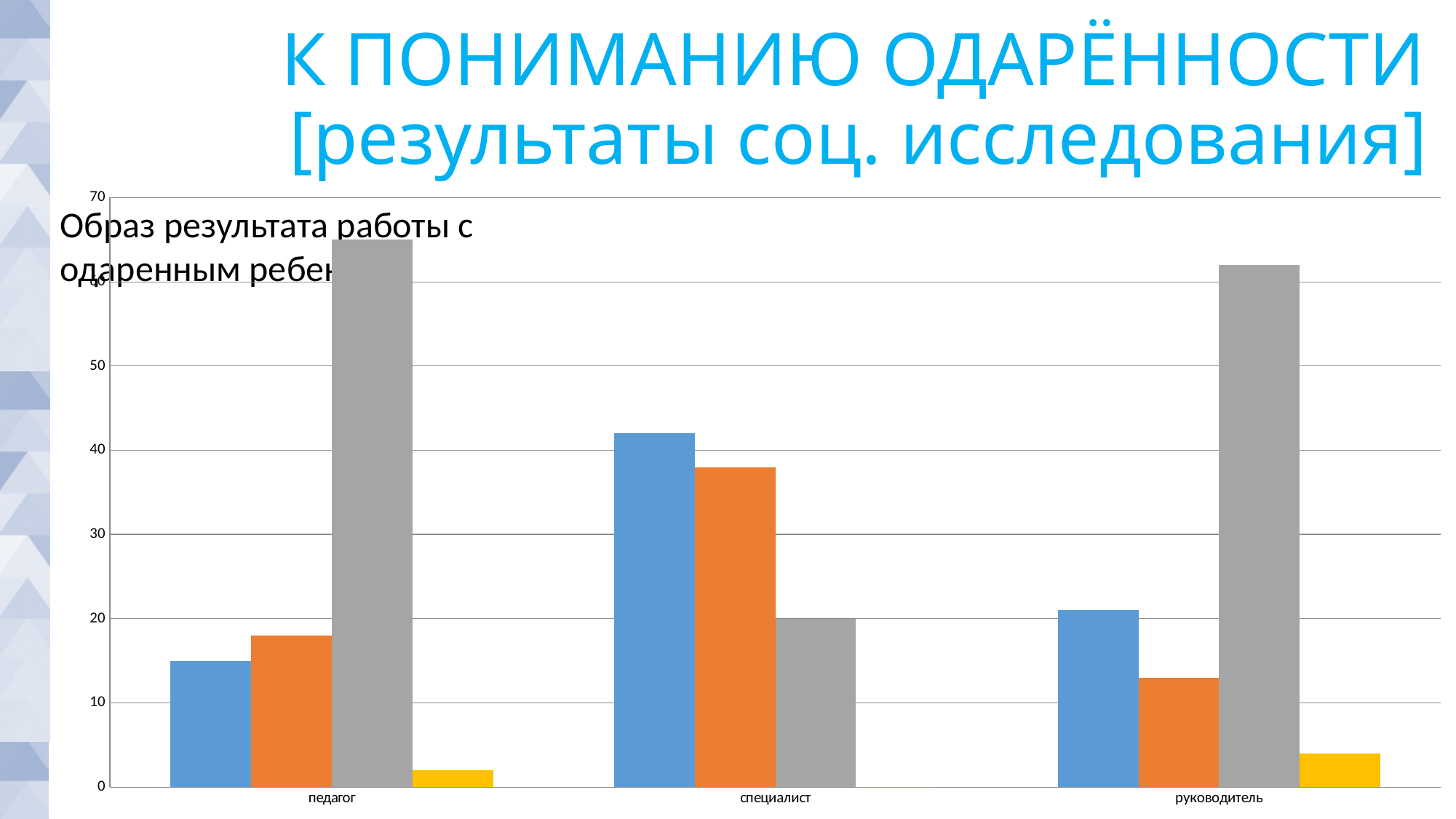
Is the gray bar for педагог greater or less than 60? greater What is the highest value shown on the y axis of the chart? 70 What kind of chart is shown on the slide? bar chart Is the orange bar for руководитель greater or less than 10? greater Which category has the tallest blue bar? специалист Is the blue bar for специалист greater or less than 40? greater Which category has the tallest gray bar? педагог Which is larger for специалист, the blue bar or the gray bar? the blue bar Which category has the shortest orange bar? руководитель Which is larger for руководитель, the gray bar or the blue bar? the gray bar How many categories are shown on the x axis of the chart? 3